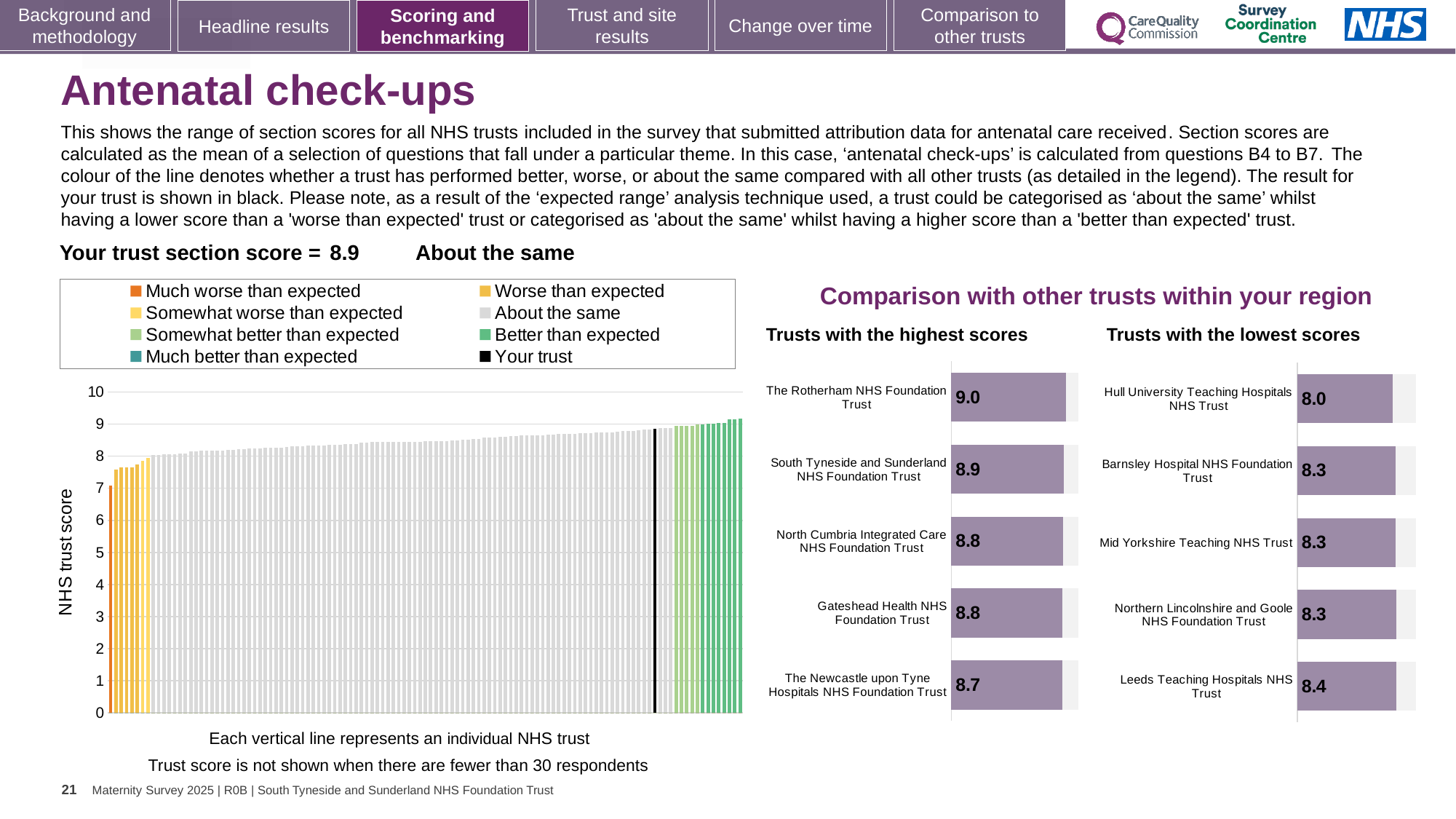
In the 'Trusts with the highest scores' chart, which trust has the highest score? The Rotherham NHS Foundation Trust In the 'Trusts with the lowest scores' chart, which has the larger score: Barnsley Hospital NHS Foundation Trust or Leeds Teaching Hospitals NHS Trust? Leeds Teaching Hospitals NHS Trust In the 'Trusts with the highest scores' chart, what is the score for The Rotherham NHS Foundation Trust? 9.0 In the 'Trusts with the highest scores' chart, what is the score for South Tyneside and Sunderland NHS Foundation Trust? 8.9 In the 'Trusts with the highest scores' chart, what is the difference between the scores of The Rotherham NHS Foundation Trust and The Newcastle upon Tyne Hospitals NHS Foundation Trust? 0.3 How many entries does the legend above the large 'NHS trust score' chart list? 8 In the large 'NHS trust score' chart on the left, is the value of the black 'Your trust' bar greater or less than 8? greater In the 'Trusts with the lowest scores' chart, what is the score for Hull University Teaching Hospitals NHS Trust? 8.0 How many trusts are shown in the 'Trusts with the highest scores' chart? 5 In the large 'NHS trust score' chart on the left, do the values rise or fall from left to right? Rise What kind of chart is the large 'NHS trust score' chart on the left of the slide? Bar chart In the 'Trusts with the lowest scores' chart, which trust has the lowest score? Hull University Teaching Hospitals NHS Trust